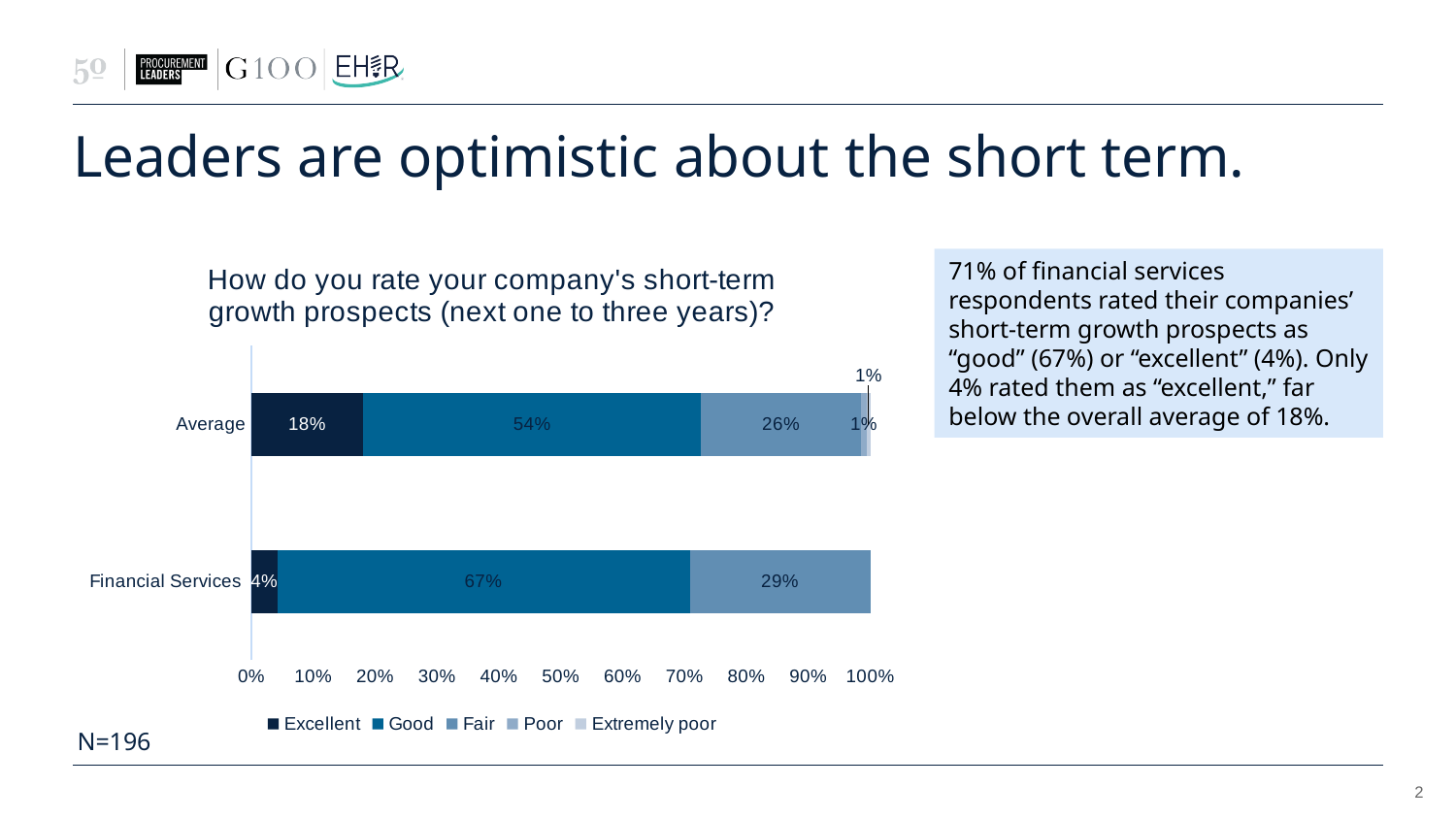
How many categories are plotted on the chart? 2 What percentage of Financial Services respondents rated their prospects as Good? 67% What is the title of the chart? How do you rate your company's short-term growth prospects (next one to three years)? What is the Excellent value for the Average category? 18% How many series does the legend list? 5 What is the Fair value for Financial Services? 29% What is the combined Excellent and Good share for Financial Services? 71% Which category has the higher Excellent value, Average or Financial Services? Average What is the Poor value for the Average category? 1% What is the difference between the Good values for Financial Services and Average? 13% What kind of chart is shown on the slide? Stacked bar chart What is the Excellent value for Financial Services? 4%